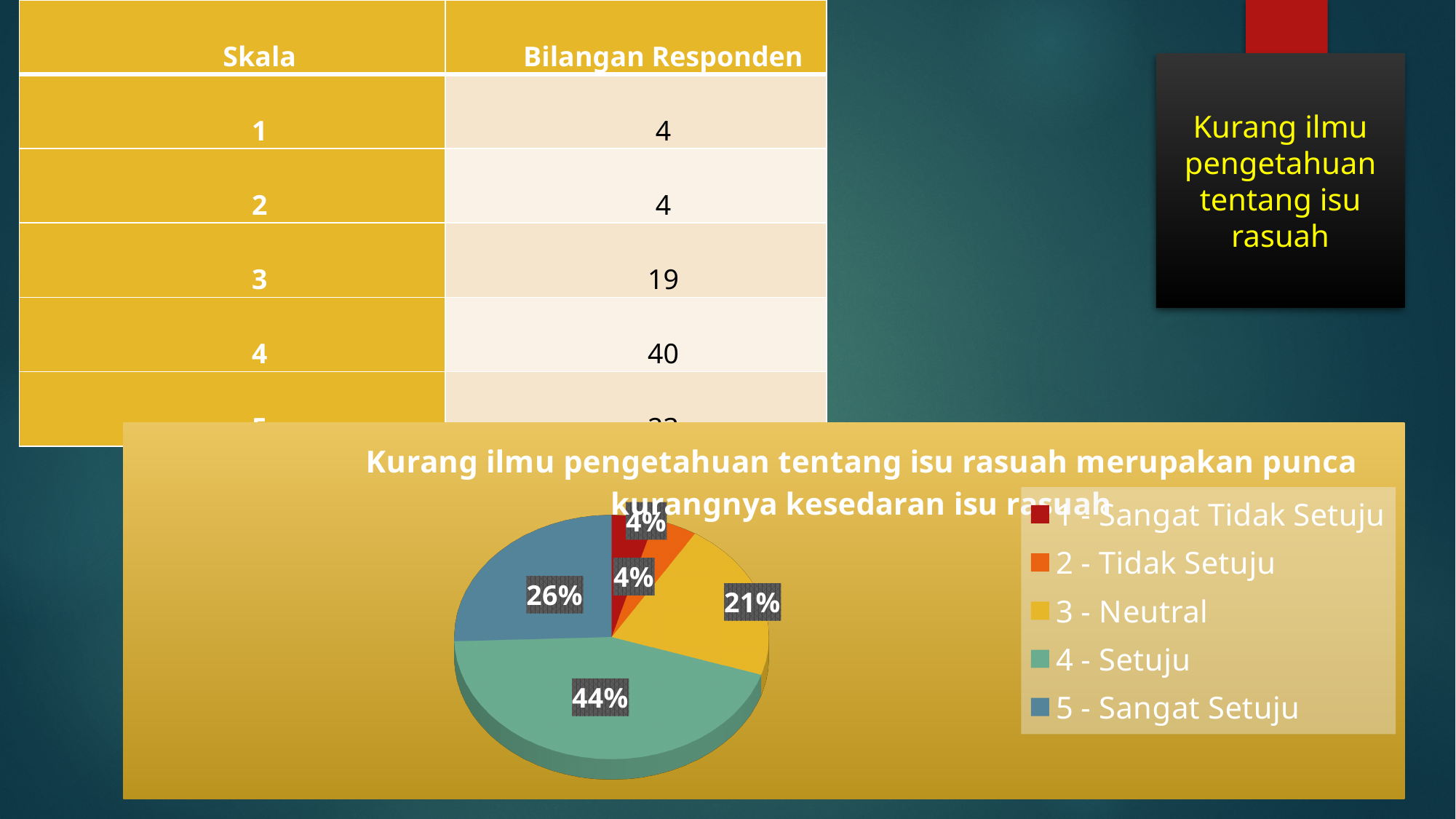
What share of the pie does the 4 - Setuju slice represent? 44% What percentage of the pie chart is labelled for 1 - Sangat Tidak Setuju? 4% What percentage of the pie chart is labelled for 5 - Sangat Setuju? 26% How many entries does the legend of the pie chart list? 5 What percentage of the pie chart is labelled for 3 - Neutral? 21% What colour is the 3 - Neutral slice in the pie chart? yellow What percentage of the pie chart is labelled for 4 - Setuju? 44% How many slices does the pie chart have? 5 Which slice is larger in the pie chart: 3 - Neutral or 5 - Sangat Setuju? 5 - Sangat Setuju What is the difference in percentage points between the 4 - Setuju slice and the 5 - Sangat Setuju slice? 18 Which category has the largest slice in the pie chart? 4 - Setuju What type of chart is shown on the slide? pie chart